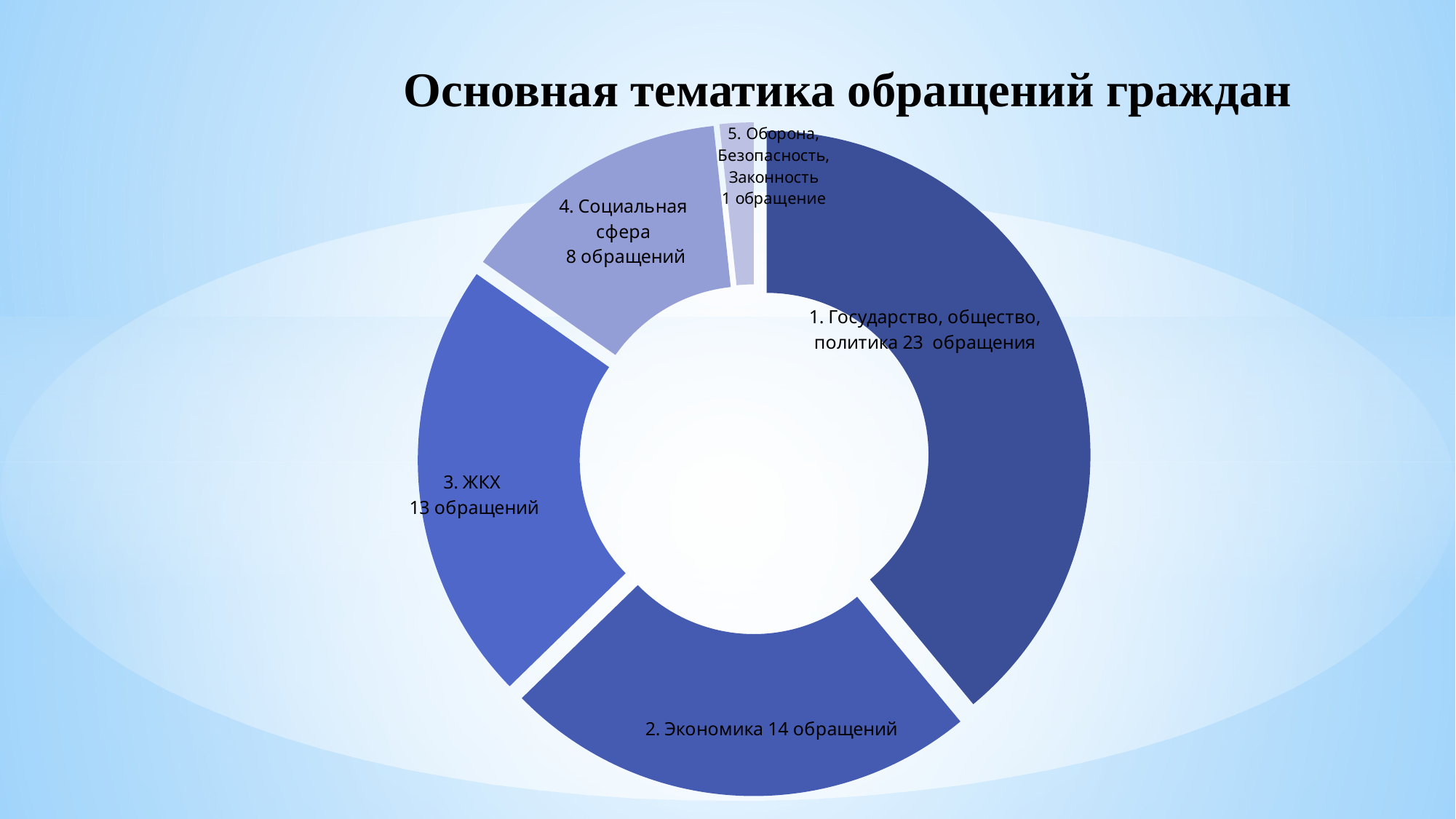
Which has more обращений: 2. Экономика or 3. ЖКХ? 2. Экономика Which category has the smallest number of обращений? 5. Оборона, Безопасность, Законность What kind of chart is shown on the slide? doughnut chart What value is shown for 3. ЖКХ? 13 обращений Which category has the largest number of обращений? 1. Государство, общество, политика How many обращений does the 4. Социальная сфера segment show? 8 обращений What is the title of the slide? Основная тематика обращений граждан How many categories does the chart show? 5 What is the difference between the number of обращений for 1. Государство, общество, политика and 2. Экономика? 9 What is the total number of обращений across all categories in the chart? 59 How many обращений are shown for 2. Экономика? 14 обращений What value is labelled for 5. Оборона, Безопасность, Законность? 1 обращение